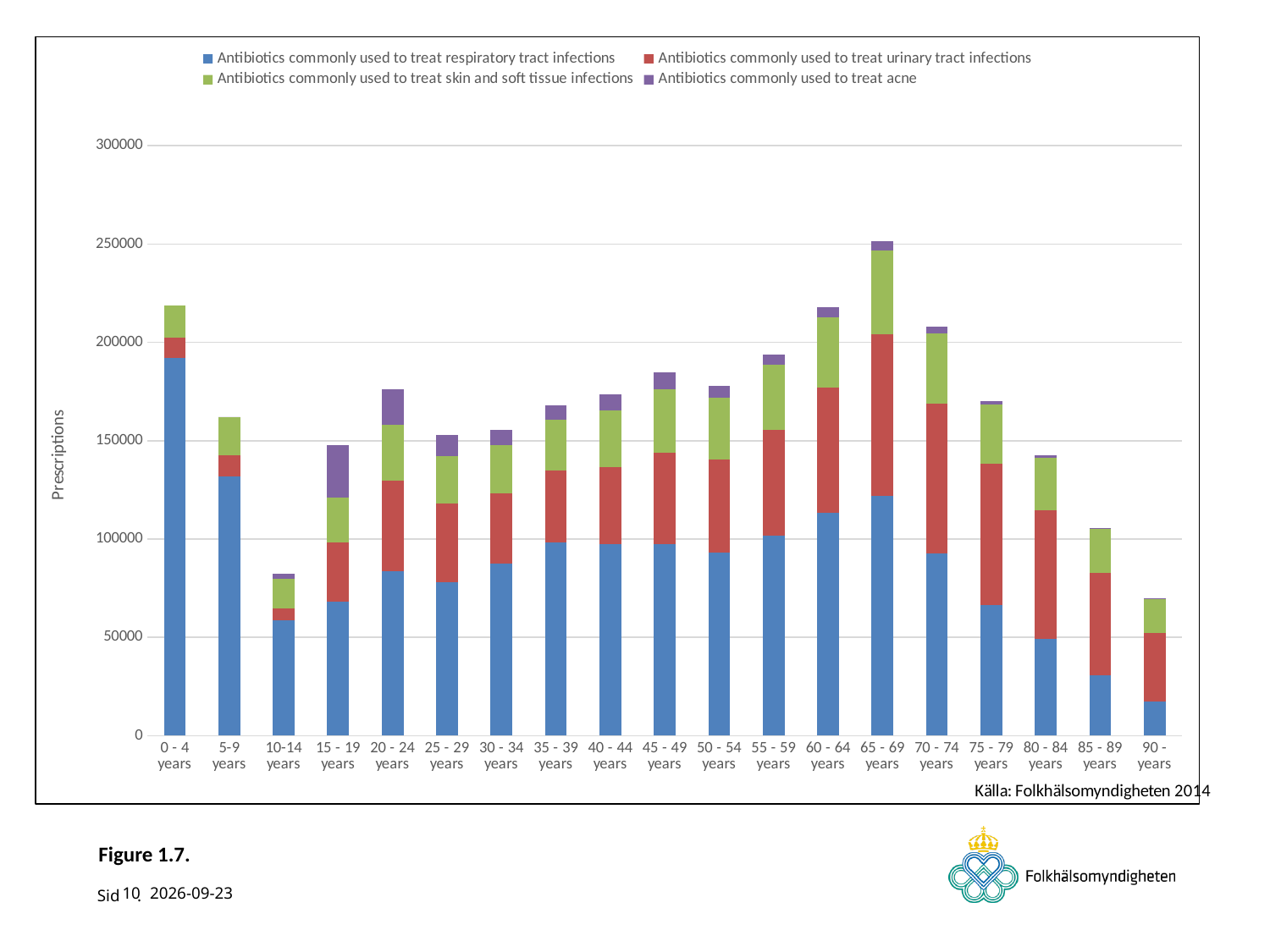
Do the total prescriptions rise or fall across the age groups from 65 - 69 years to 90 - years? fall Which age group has the highest total number of prescriptions? 65 - 69 years What kind of chart is shown on the slide? Stacked bar chart How many series does the legend list? 4 Is the total number of prescriptions for 10-14 years greater or less than 100000? less Is the total number of prescriptions for 0 - 4 years greater or less than 200000? greater Which age group has the lowest total number of prescriptions? 90 - years What is the label on the y axis? Prescriptions Which colour represents antibiotics commonly used to treat acne in the legend? Purple Which age group has a higher total number of prescriptions, 0 - 4 years or 5-9 years? 0 - 4 years Is the value for antibiotics commonly used to treat respiratory tract infections in the 0 - 4 years group greater or less than 150000? greater How many age groups are shown along the x axis? 19